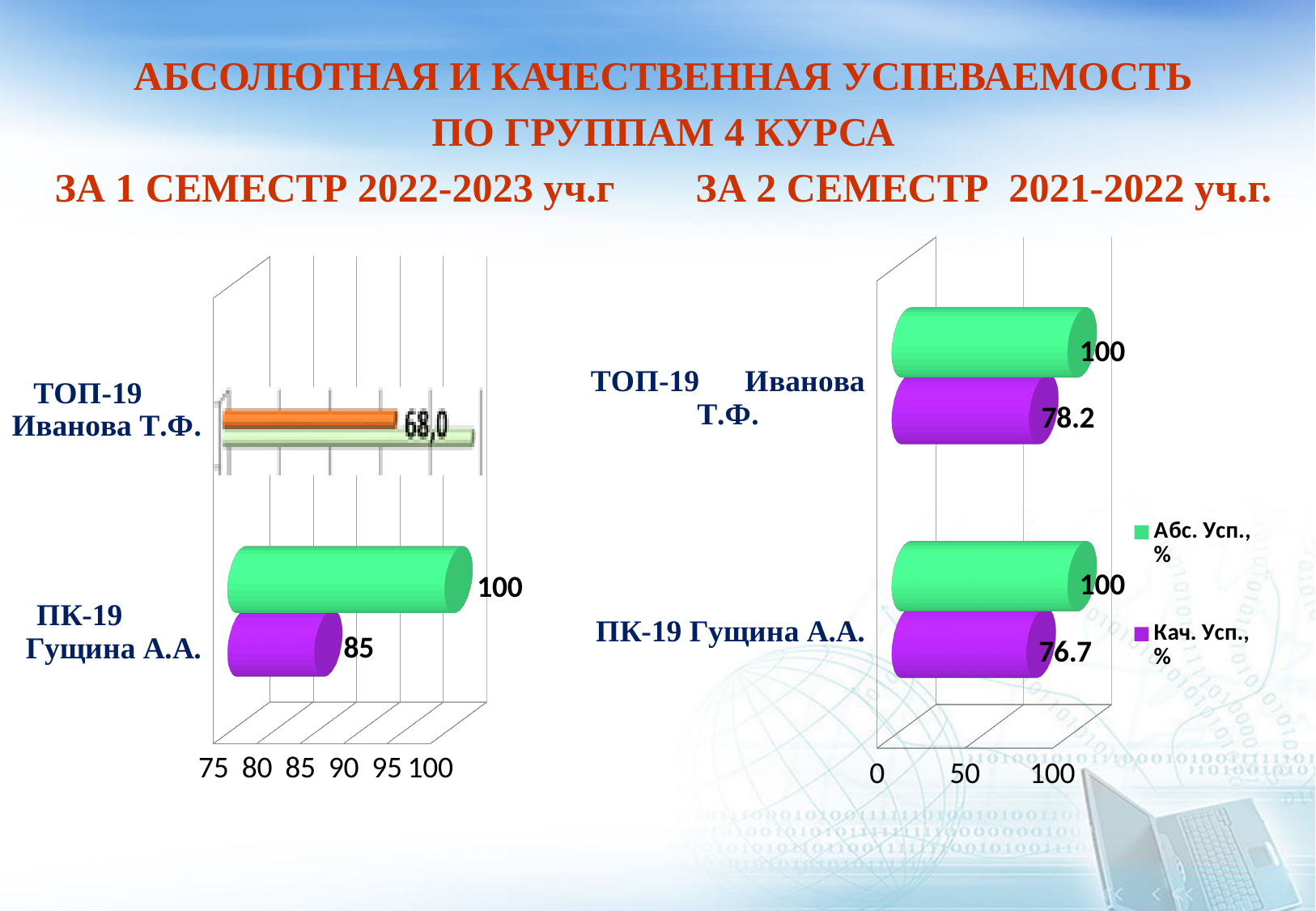
In the right chart (ЗА 2 СЕМЕСТР 2021-2022 уч.г.), what is the Кач. Усп., % value for ТОП-19 Иванова Т.Ф.? 78.2 In the right chart (ЗА 2 СЕМЕСТР 2021-2022 уч.г.), what is the difference between the Абс. Усп., % and Кач. Усп., % values for ТОП-19 Иванова Т.Ф.? 21.8 In the left chart (ЗА 1 СЕМЕСТР 2022-2023 уч.г), what is the difference between the green and purple bars for ПК-19 Гущина А.А.? 15 In the right chart (ЗА 2 СЕМЕСТР 2021-2022 уч.г.), which group has the higher Кач. Усп., % value? ТОП-19 Иванова Т.Ф. In the right chart (ЗА 2 СЕМЕСТР 2021-2022 уч.г.), what is the Кач. Усп., % value for ПК-19 Гущина А.А.? 76.7 In the left chart (ЗА 1 СЕМЕСТР 2022-2023 уч.г), what is the value of the green bar for ПК-19 Гущина А.А.? 100 In the left chart (ЗА 1 СЕМЕСТР 2022-2023 уч.г), what is the value of the purple bar for ПК-19 Гущина А.А.? 85 In the right chart (ЗА 2 СЕМЕСТР 2021-2022 уч.г.), what is the difference between the Кач. Усп., % values of ТОП-19 Иванова Т.Ф. and ПК-19 Гущина А.А.? 1.5 In the right chart (ЗА 2 СЕМЕСТР 2021-2022 уч.г.), what is the Абс. Усп., % value for ТОП-19 Иванова Т.Ф.? 100 In the right chart (ЗА 2 СЕМЕСТР 2021-2022 уч.г.), which series is shown in purple according to the legend? Кач. Усп., % What type of chart is the right chart (ЗА 2 СЕМЕСТР 2021-2022 уч.г.)? Bar chart How many series does the legend of the right chart (ЗА 2 СЕМЕСТР 2021-2022 уч.г.) list? 2